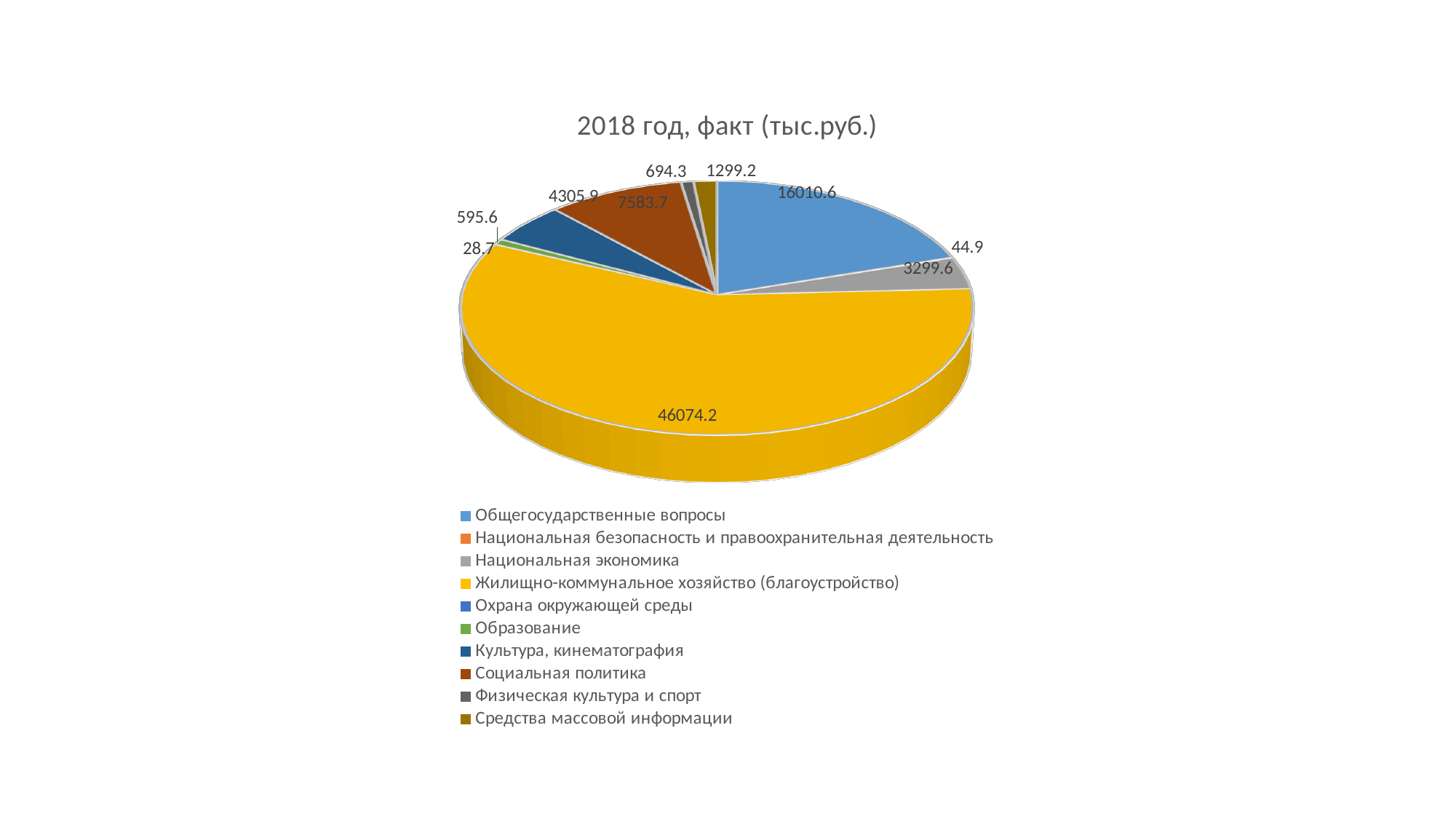
Which category has the largest slice? Жилищно-коммунальное хозяйство (благоустройство) What is the value for Охрана окружающей среды? 28.7 Which category has the smallest value? Охрана окружающей среды What is the value for Социальная политика? 7583.7 What is the value for Жилищно-коммунальное хозяйство (благоустройство)? 46074.2 What is the title of the chart? 2018 год, факт (тыс.руб.) Which is larger, Культура, кинематография or Национальная экономика? Культура, кинематография How many categories does the legend list? 10 What is the difference between Общегосударственные вопросы and Социальная политика? 8426.9 What is the value for Общегосударственные вопросы? 16010.6 What is the difference between Жилищно-коммунальное хозяйство (благоустройство) and Общегосударственные вопросы? 30063.6 What type of chart is shown on the slide? Pie chart